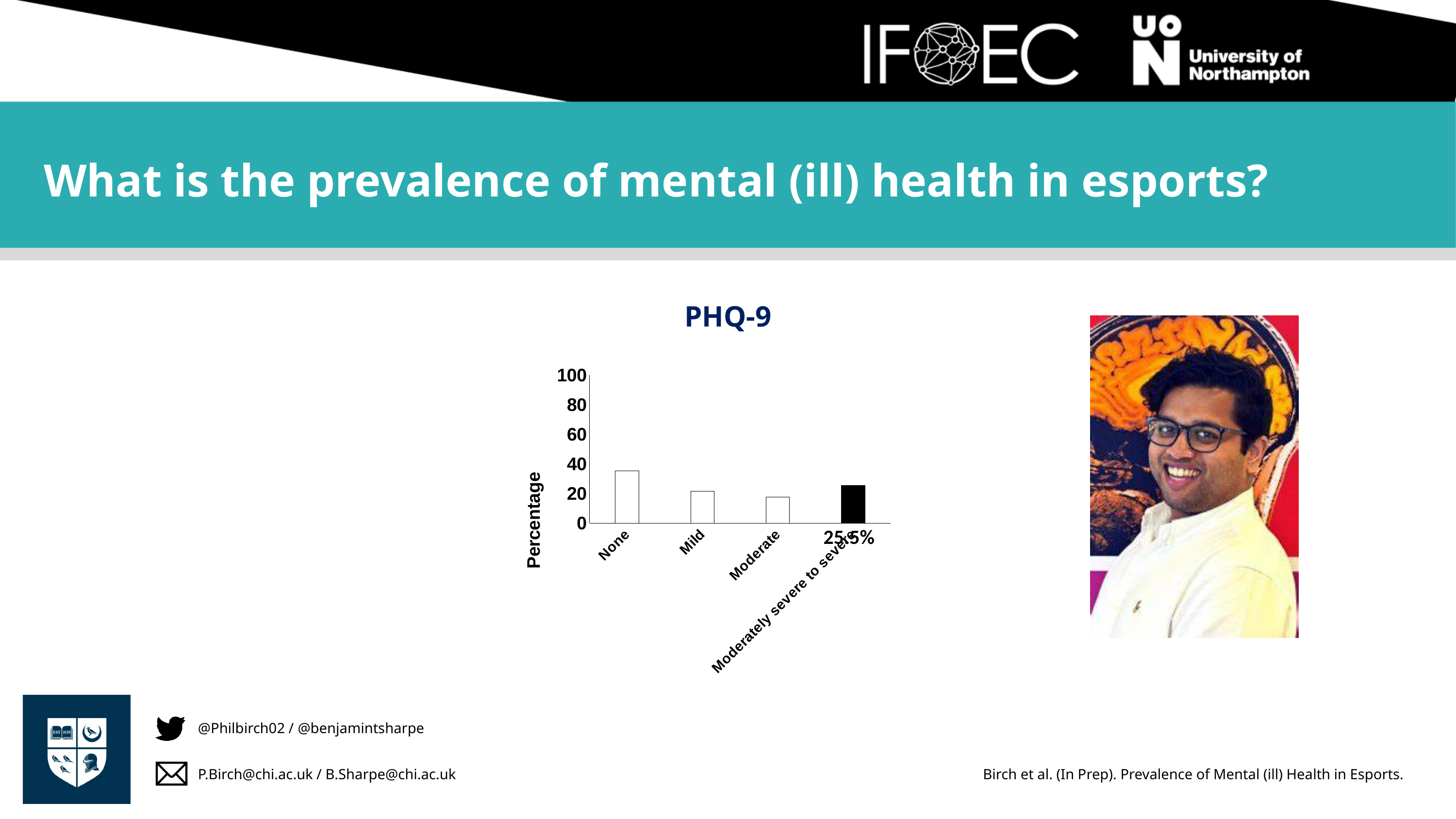
How many categories are shown on the x axis of the PHQ-9 chart? 4 What kind of chart is the PHQ-9 chart? bar chart What is the title of the chart on the slide? PHQ-9 What is the label on the y axis of the PHQ-9 chart? Percentage Is the value for None in the PHQ-9 chart greater or less than 20? greater In the PHQ-9 chart, which is larger, the value for None or the value for Mild? None Which category has the highest value in the PHQ-9 chart? None What is the value for Moderately severe to severe in the PHQ-9 chart? 25.5% Is the value for Moderately severe to severe in the PHQ-9 chart greater or less than 20? greater In the PHQ-9 chart, which is larger, the value for None or the value for Moderately severe to severe? None Is the value for Mild in the PHQ-9 chart greater or less than 40? less